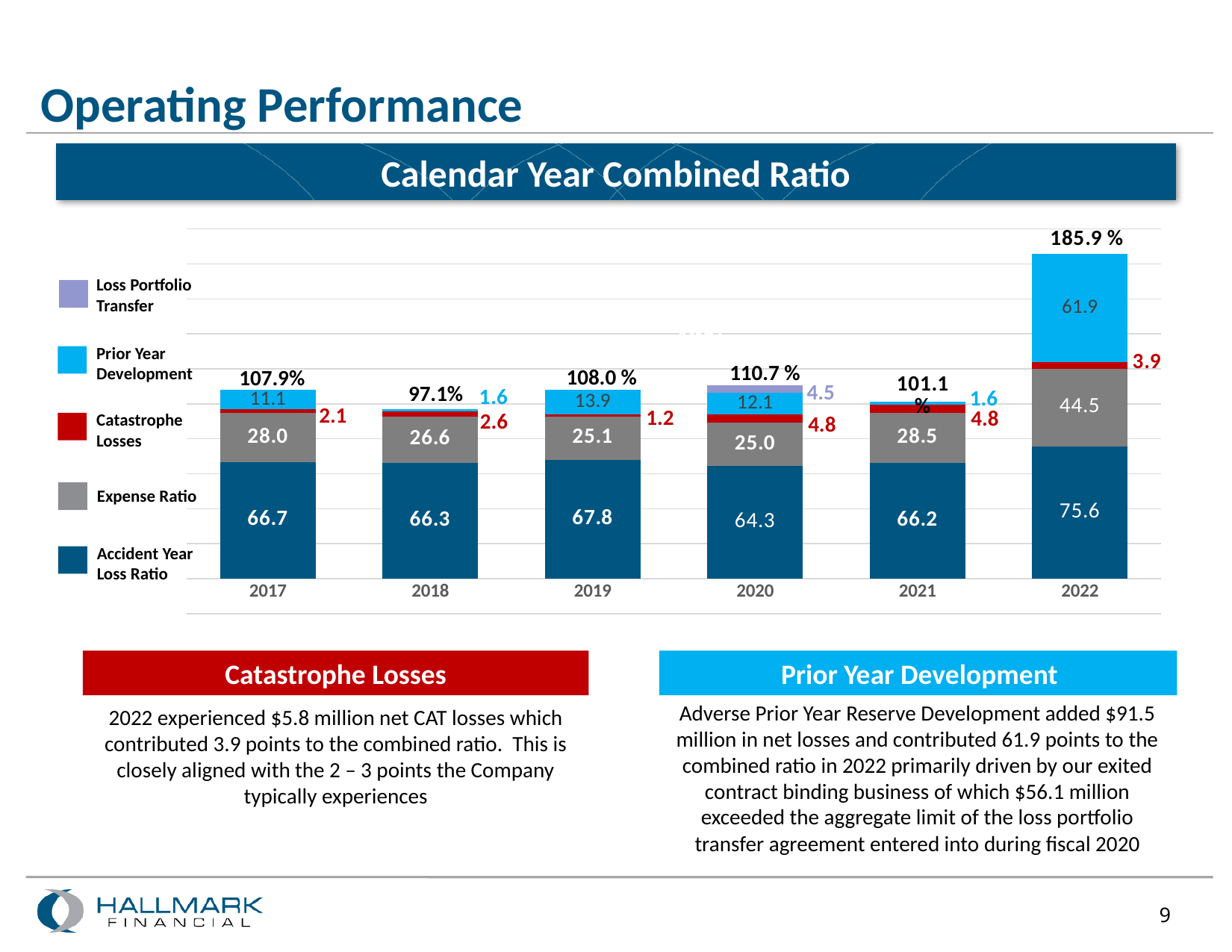
What is the Prior Year Development value for 2019? 13.9 What is the Catastrophe Losses value for 2020? 4.8 What is the Accident Year Loss Ratio for 2022? 75.6 Is the Accident Year Loss Ratio larger in 2019 or in 2020? 2019 What is the total combined ratio shown for 2020? 110.7 % How many years are shown on the x axis of the chart? 6 Which year has the highest combined ratio? 2022 What is the difference between the Expense Ratio in 2022 and in 2021? 16.0 Which year has the lowest combined ratio? 2018 What is the Expense Ratio for 2018? 26.6 What type of chart is used to show the Calendar Year Combined Ratio? Stacked bar chart How many series does the chart legend list? 5